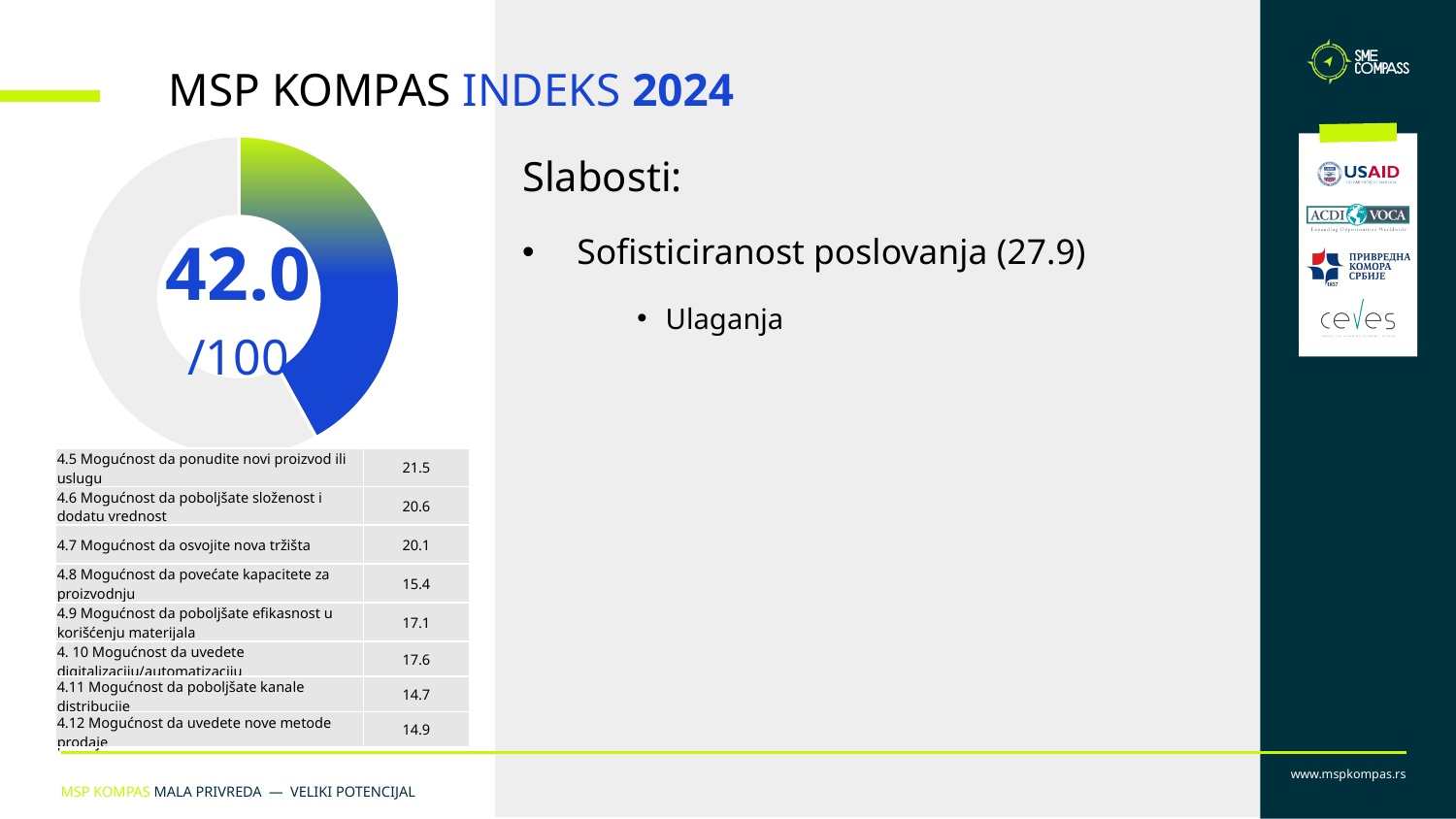
What is the title of the slide containing the doughnut chart? MSP KOMPAS INDEKS 2024 Is the value shown in the doughnut chart greater or less than 50? less How many segments does the doughnut chart have? 2 Is the coloured segment of the doughnut chart larger or smaller than the grey segment? smaller What kind of chart is shown on the left of the slide? doughnut chart Out of what maximum is the doughnut chart's value expressed? 100 What share of the doughnut chart is filled by the coloured (blue-green) segment? 42.0% What value is printed in the centre of the doughnut chart? 42.0